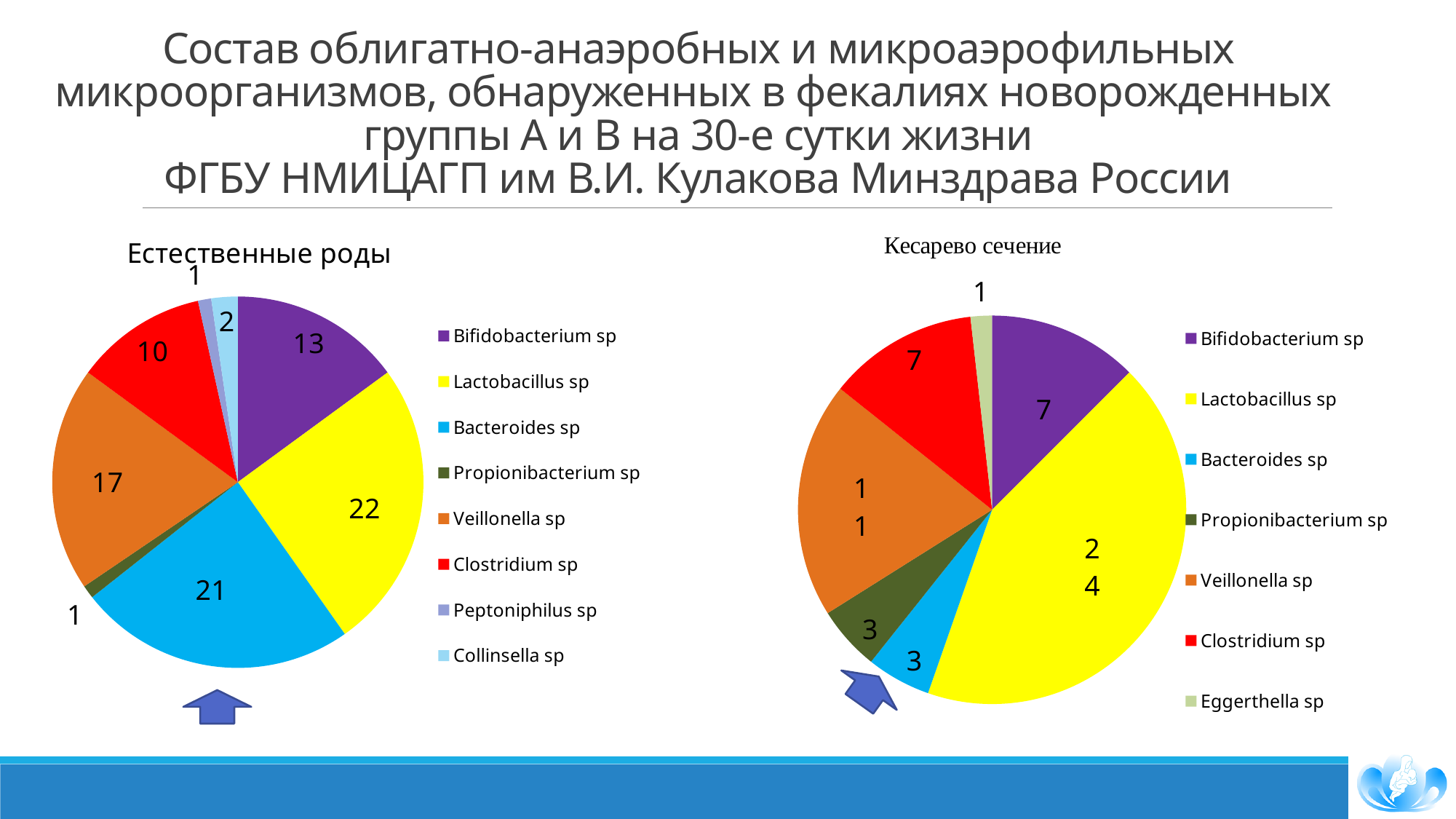
Which category appears in the legend of the "Кесарево сечение" chart but not in the "Естественные роды" chart? Eggerthella sp In the "Естественные роды" chart, what is the value for Veillonella sp? 17 What type of chart is used for "Естественные роды"? pie chart In the "Кесарево сечение" chart, what is the value for Lactobacillus sp? 24 In the "Кесарево сечение" chart, which category has the lowest value? Eggerthella sp In the "Естественные роды" chart, what is the difference between Bacteroides sp and Clostridium sp? 11 Which chart has the larger value for Bacteroides sp: "Естественные роды" or "Кесарево сечение"? Естественные роды In the "Естественные роды" chart, what is the value for Lactobacillus sp? 22 In the "Кесарево сечение" chart, what is the value for Veillonella sp? 11 How many categories does the legend of the "Естественные роды" chart list? 8 In the "Естественные роды" chart, which category has the highest value? Lactobacillus sp In the "Кесарево сечение" chart, which is larger: Bifidobacterium sp or Bacteroides sp? Bifidobacterium sp